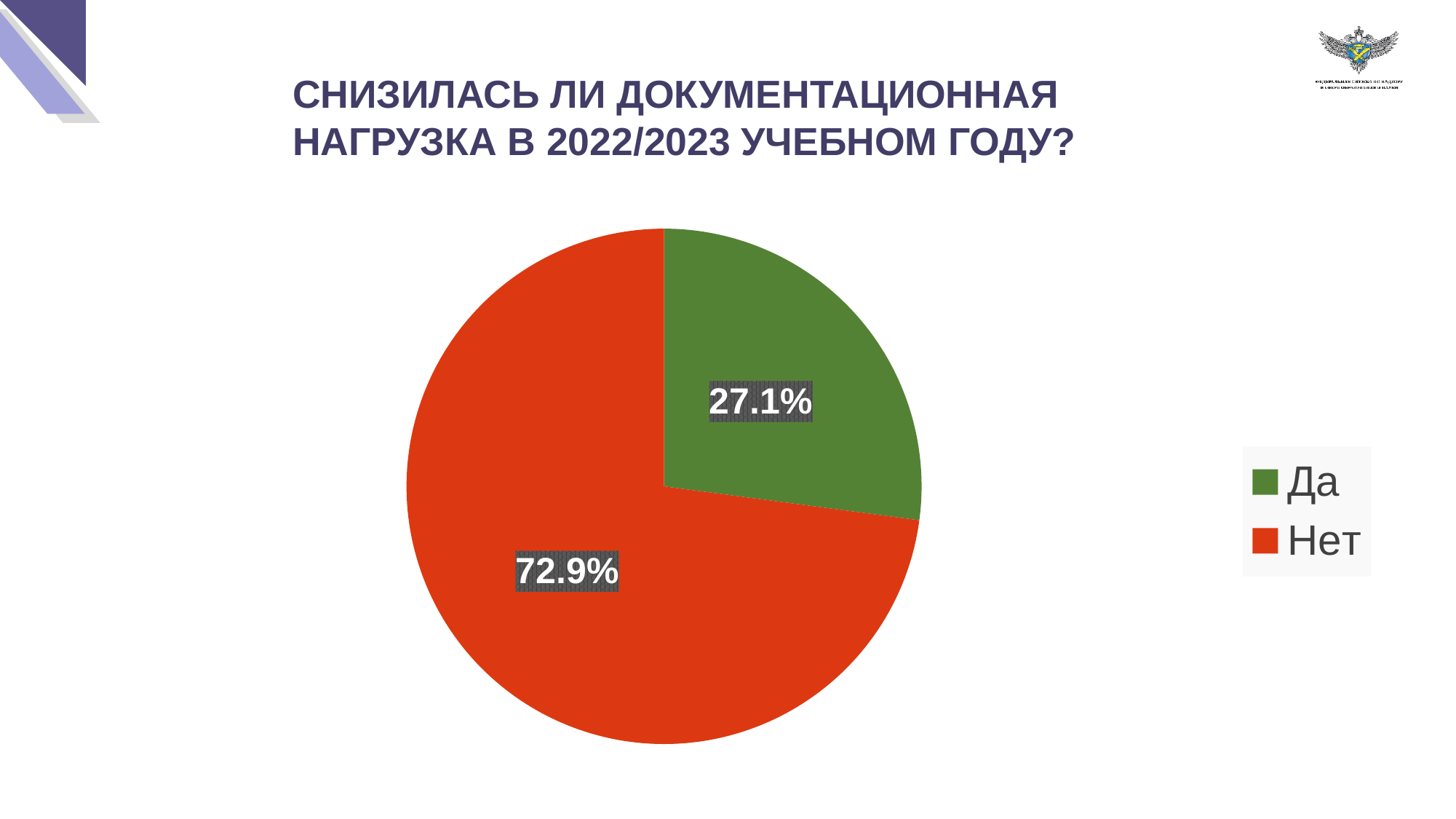
What colour is the "Нет" slice? red Which slice is larger, "Да" or "Нет"? Нет What share of respondents answered "Да"? 27.1% Which answer has the largest slice of the pie? Нет How many slices does the pie chart have? 2 What is the difference in percentage points between the "Нет" and "Да" slices? 45.8 How many entries does the legend list? 2 What share of respondents answered "Нет"? 72.9% Which answer has the smallest slice of the pie? Да What kind of chart is shown on the slide? pie chart What colour is the "Да" slice? green